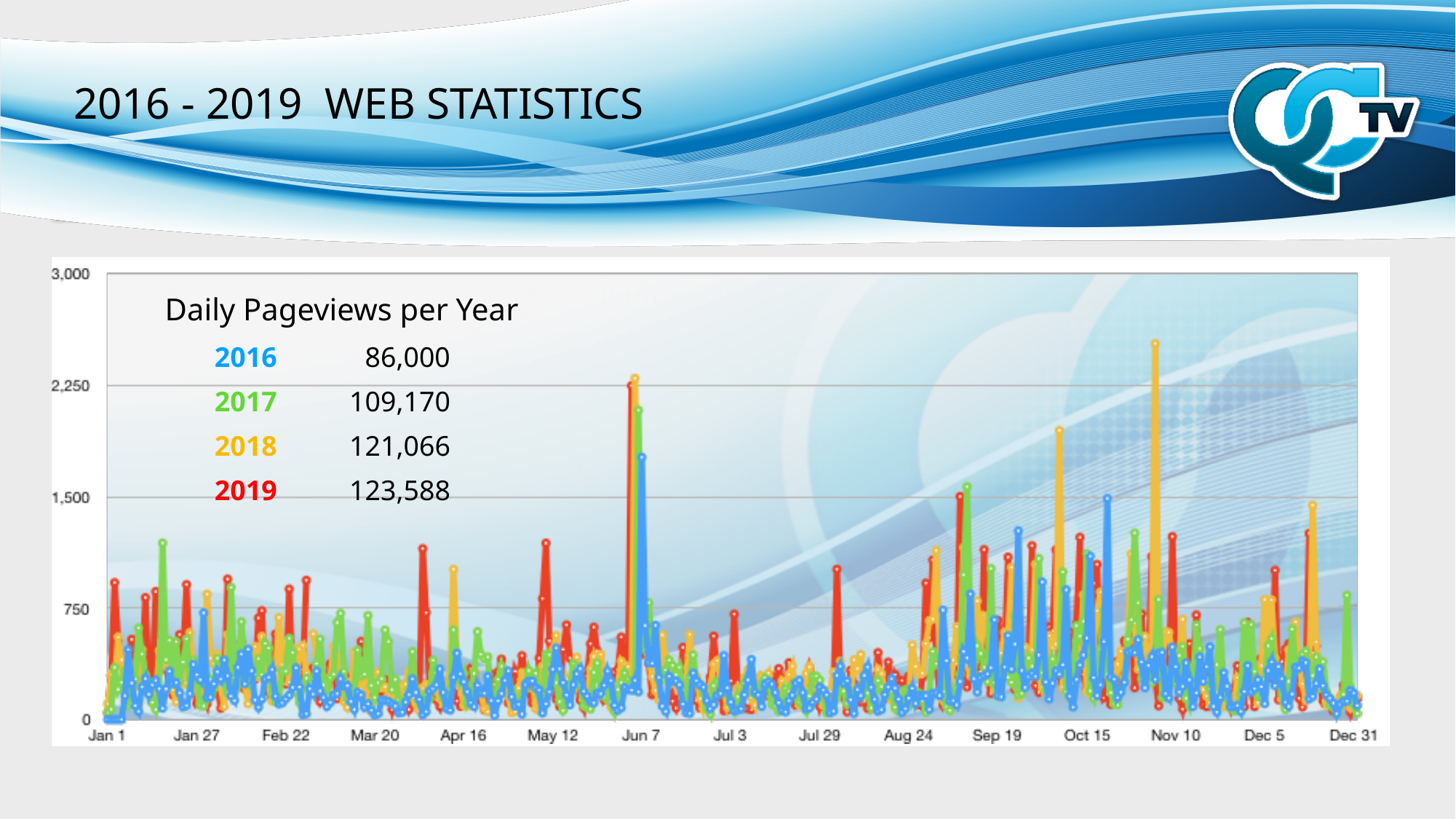
Which year has the highest annual pageview total? 2019 Which annual total is larger, 2017 or 2018? 2018 Do the annual pageview totals rise or fall from 2016 to 2019? rise Which year has the lowest annual pageview total? 2016 Which colour represents the 2019 series in the chart? red What is the difference between the 2019 and 2018 annual pageview totals? 2,522 How many years (series) are plotted in the Daily Pageviews per Year chart? 4 What kind of chart is shown on the slide? line chart What is the annual pageview total listed for 2016? 86,000 Is the highest spike on the chart, the yellow 2018 peak near Nov 10, greater or less than 2,250? greater What is the annual pageview total listed for 2019? 123,588 What is the annual pageview total listed for 2018? 121,066